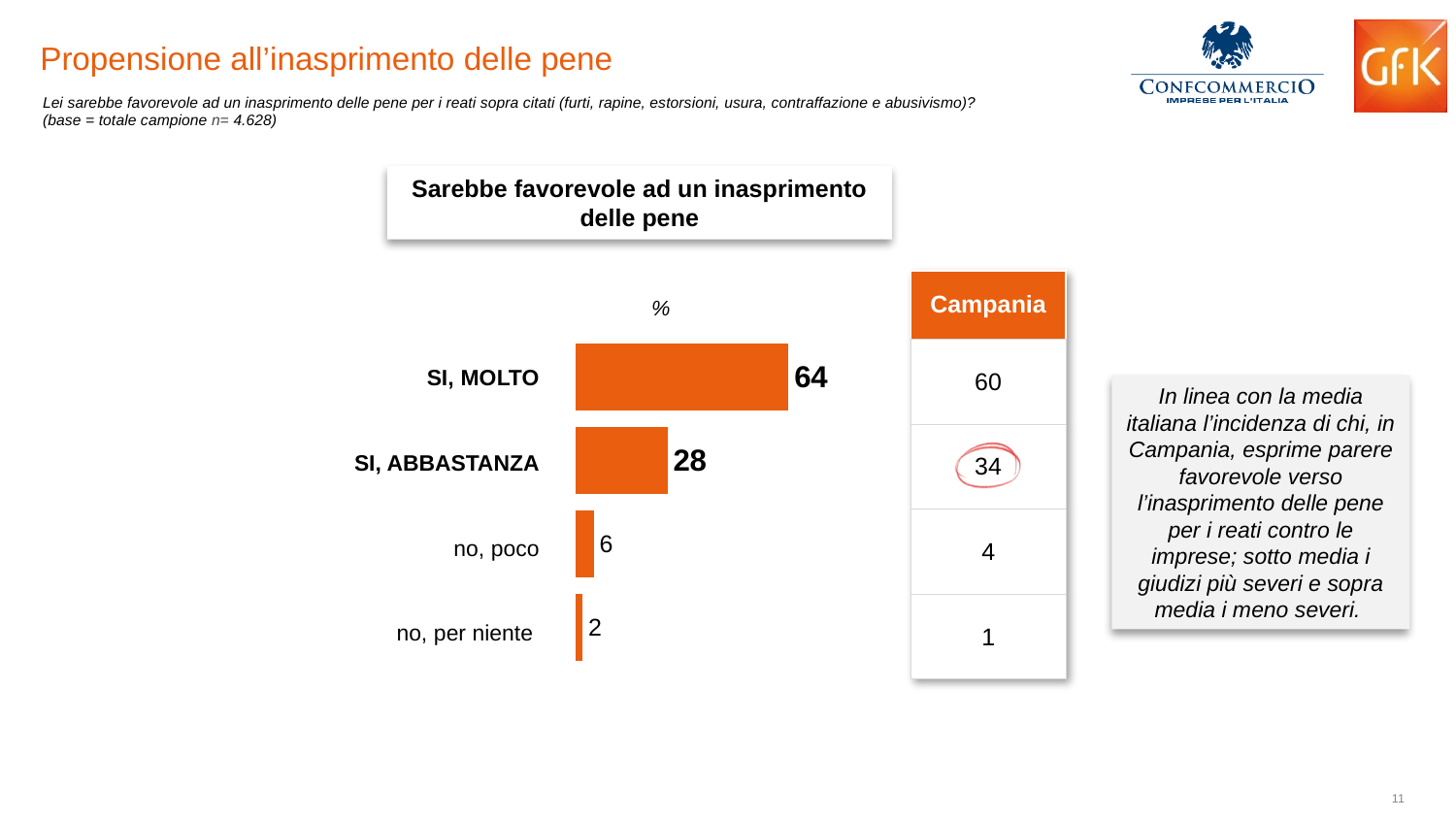
What is the value for SI, ABBASTANZA in the bar chart? 28 What is the difference between the values for SI, MOLTO and SI, ABBASTANZA in the bar chart? 36 Which category has the highest value in the bar chart? SI, MOLTO Which category has the lowest value in the bar chart? no, per niente What is the value for SI, MOLTO in the bar chart? 64 What is the title shown above the bar chart? Sarebbe favorevole ad un inasprimento delle pene What kind of chart is shown on the slide? bar chart What is the value for no, per niente in the bar chart? 2 What is the value for no, poco in the bar chart? 6 What is the total of the values for SI, MOLTO and SI, ABBASTANZA in the bar chart? 92 Which is larger in the bar chart, the value for no, poco or the value for no, per niente? no, poco How many categories are shown in the bar chart? 4